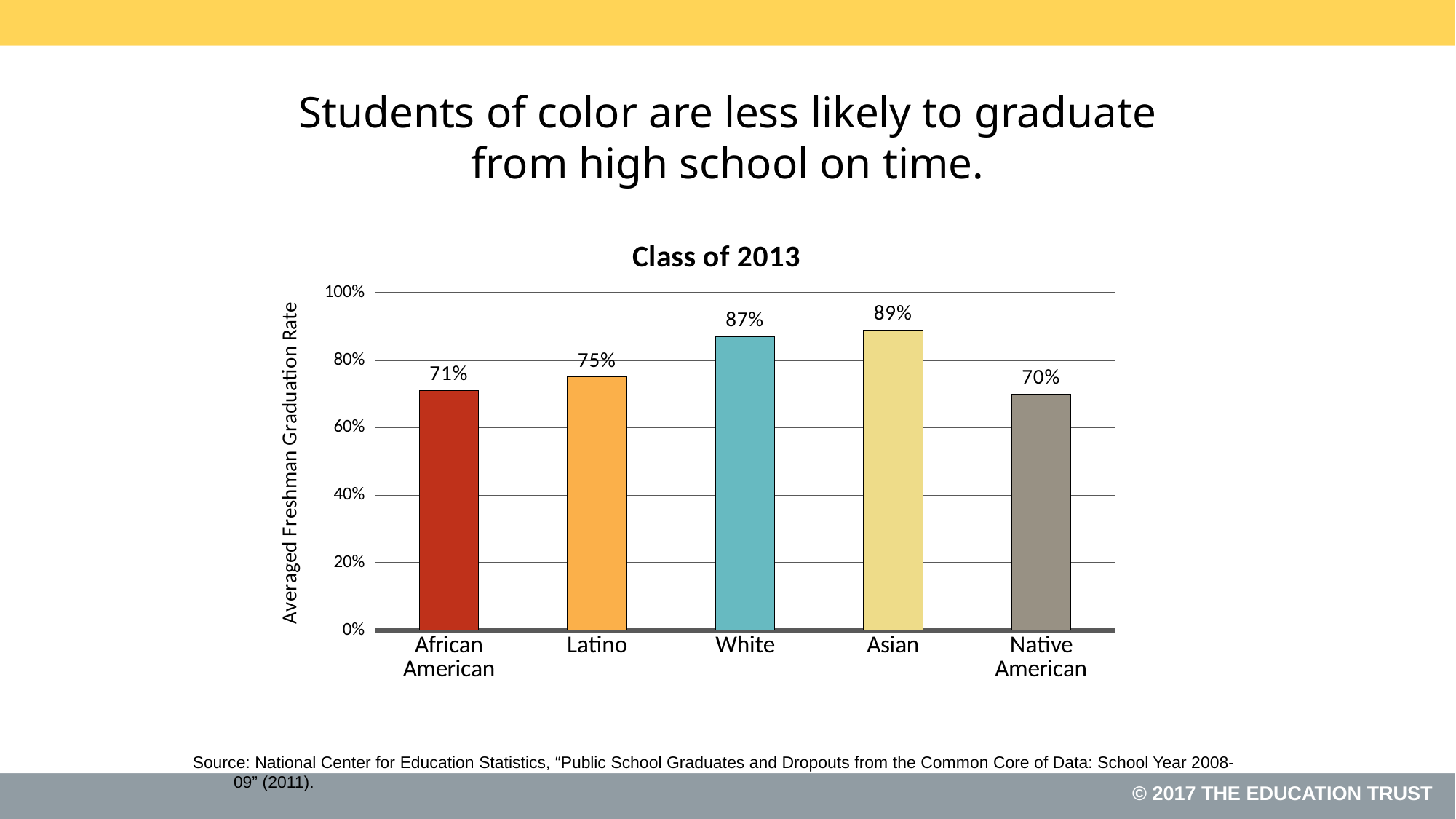
What is the averaged freshman graduation rate for Asian students? 89% What is the difference between the graduation rates for White and Latino students? 12% What is the difference between the graduation rates for Asian and African American students? 18% How many groups are shown on the x axis? 5 What kind of chart is shown on the slide? Bar chart What is the averaged freshman graduation rate for Native American students? 70% Is the value for Latino students greater or less than 80%? less What is the title of the chart? Class of 2013 What is the averaged freshman graduation rate for African American students? 71% Which group has the lowest averaged freshman graduation rate? Native American Which is larger, the graduation rate for Latino students or for White students? White Which group has the highest averaged freshman graduation rate? Asian